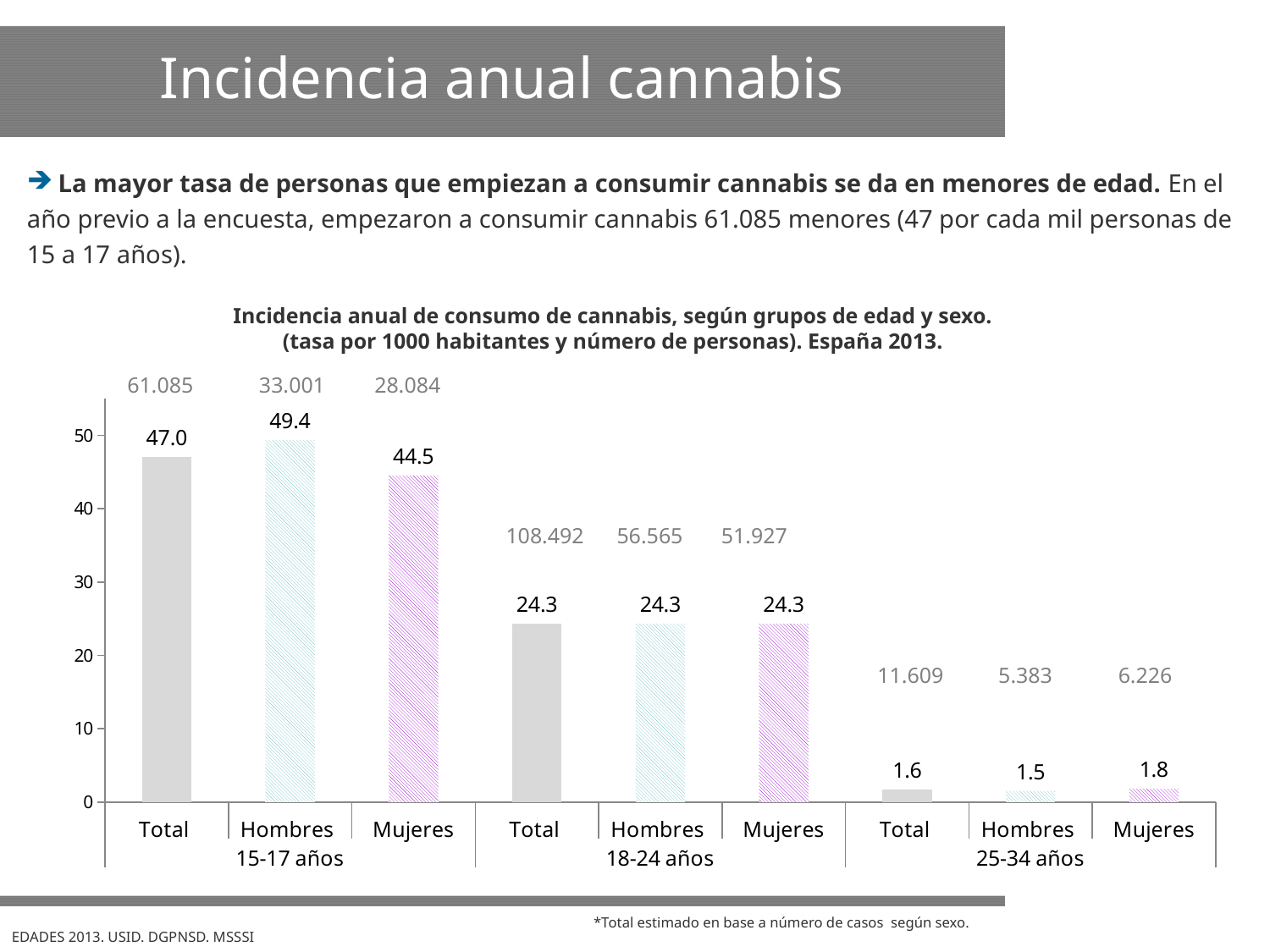
How many bars are plotted in the chart? 9 What is the difference between the rates for Hombres and Mujeres in the 15-17 años group? 4.9 Which is larger, the rate for Mujeres in the 25-34 años group or the rate for Hombres in the 25-34 años group? Mujeres Which bar has the lowest rate in the chart? Hombres, 25-34 años How many age groups are shown on the x axis? 3 What is the rate (per 1000 inhabitants) for Hombres in the 15-17 años group? 49.4 What is the rate for Mujeres in the 15-17 años group? 44.5 Is the rate for Total in the 15-17 años group greater or less than 40? greater What number of persons is shown above the Total bar for the 18-24 años group? 108.492 What is the rate for Total in the 25-34 años group? 1.6 Which bar has the highest rate in the chart? Hombres, 15-17 años What kind of chart is shown on the slide? Bar chart